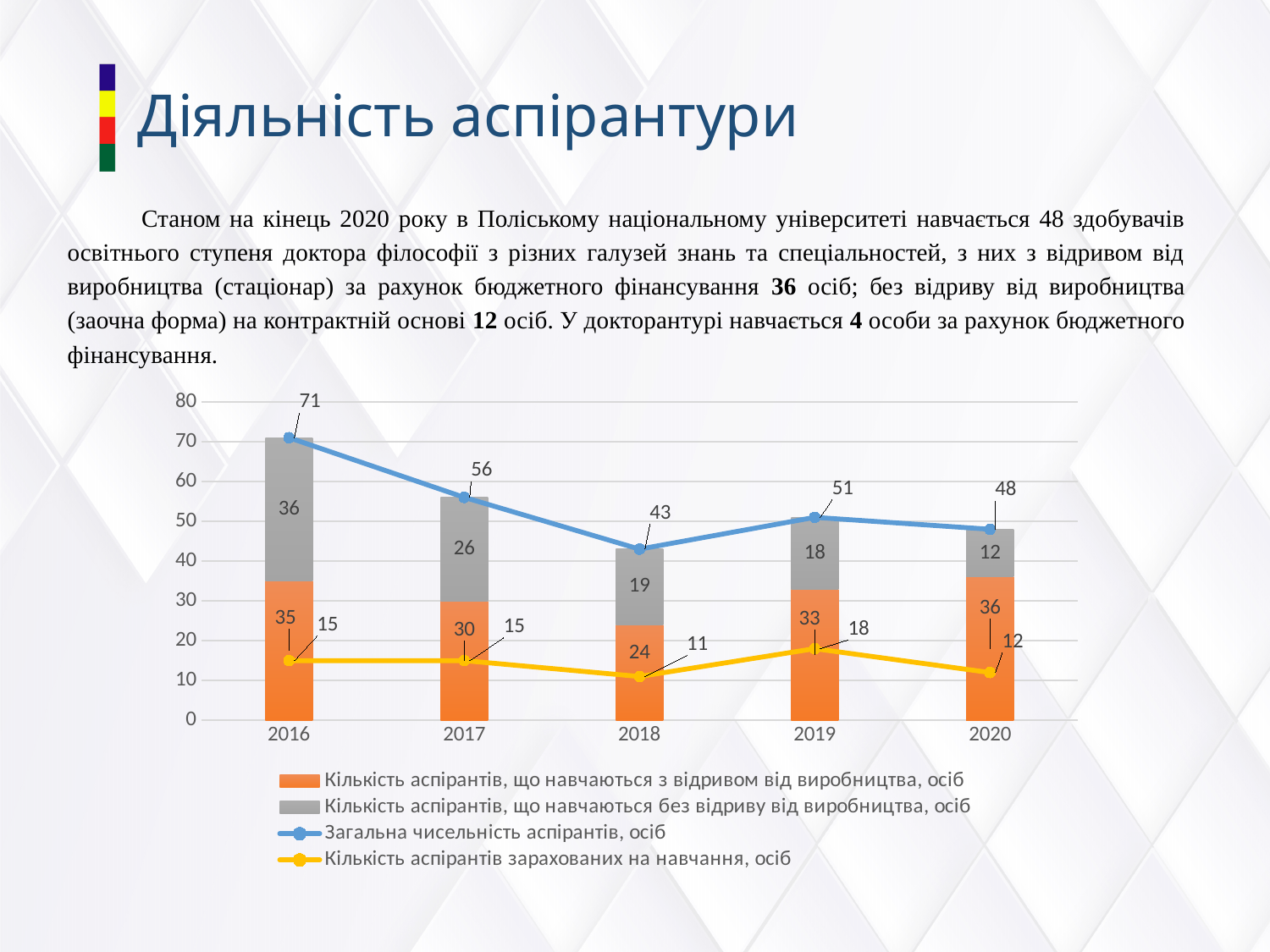
What is the difference between 'Загальна чисельність аспірантів, осіб' in 2016 and in 2020? 23 In which year is 'Кількість аспірантів, що навчаються з відривом від виробництва, осіб' the highest? 2020 In which year is 'Загальна чисельність аспірантів, осіб' the lowest? 2018 Which is larger in 2017: 'Кількість аспірантів, що навчаються з відривом від виробництва, осіб' or 'Кількість аспірантів, що навчаються без відриву від виробництва, осіб'? Кількість аспірантів, що навчаються з відривом від виробництва, осіб What is the total of the stacked bar for 2019? 51 What is the value of 'Кількість аспірантів зарахованих на навчання, осіб' in 2019? 18 How many series does the legend list? 4 What kind of chart is shown on the slide? Combined stacked bar and line chart How many years are shown on the x axis? 5 What is the value of 'Загальна чисельність аспірантів, осіб' in 2016? 71 What is the value of 'Кількість аспірантів, що навчаються без відриву від виробництва, осіб' in 2018? 19 Does 'Кількість аспірантів, що навчаються без відриву від виробництва, осіб' rise or fall from 2016 to 2020? Fall